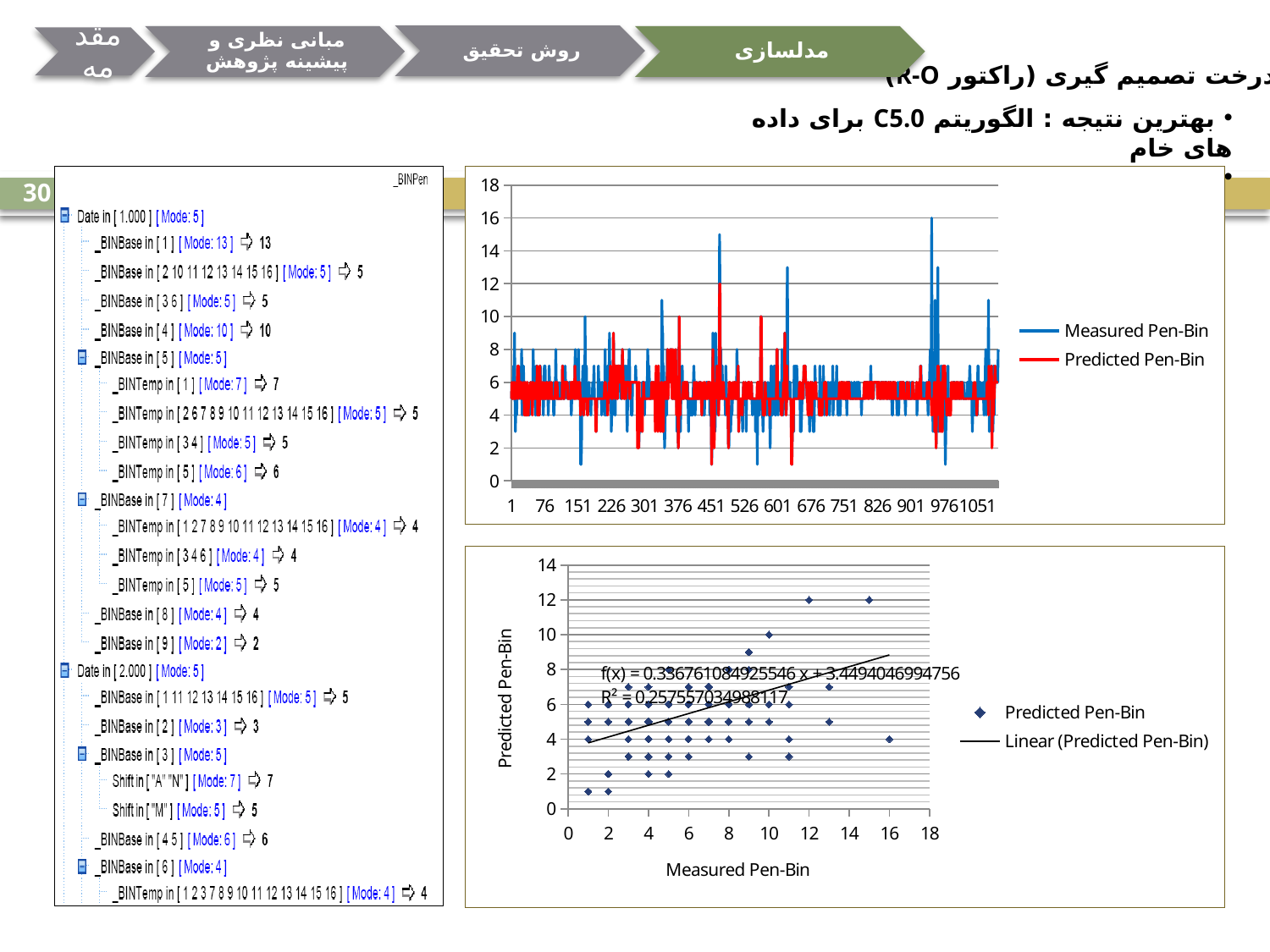
In the top-right line chart, which series reaches the higher peak value, Measured Pen-Bin or Predicted Pen-Bin? Measured Pen-Bin In the bottom-right scatter chart, what R² value is shown for the linear trendline? 0.257557034988117 What is the x-axis title of the bottom-right scatter chart? Measured Pen-Bin What kind of chart is the top-right chart with Measured Pen-Bin and Predicted Pen-Bin? line chart In the top-right line chart, which series is drawn in red? Predicted Pen-Bin What kind of chart is the bottom-right chart plotting Predicted Pen-Bin against Measured Pen-Bin? scatter chart In the top-right line chart, is the highest value of Measured Pen-Bin greater or less than 14? greater In the bottom-right scatter chart, what is the intercept of the linear trendline equation f(x)? 3.4494046994756 How many entries does the legend of the bottom-right scatter chart list? 2 In the bottom-right scatter chart, what is the slope of the linear trendline equation f(x)? 0.336761084925546 In the bottom-right scatter chart, is the highest Predicted Pen-Bin value greater or less than 10? greater How many series does the legend of the top-right line chart list? 2